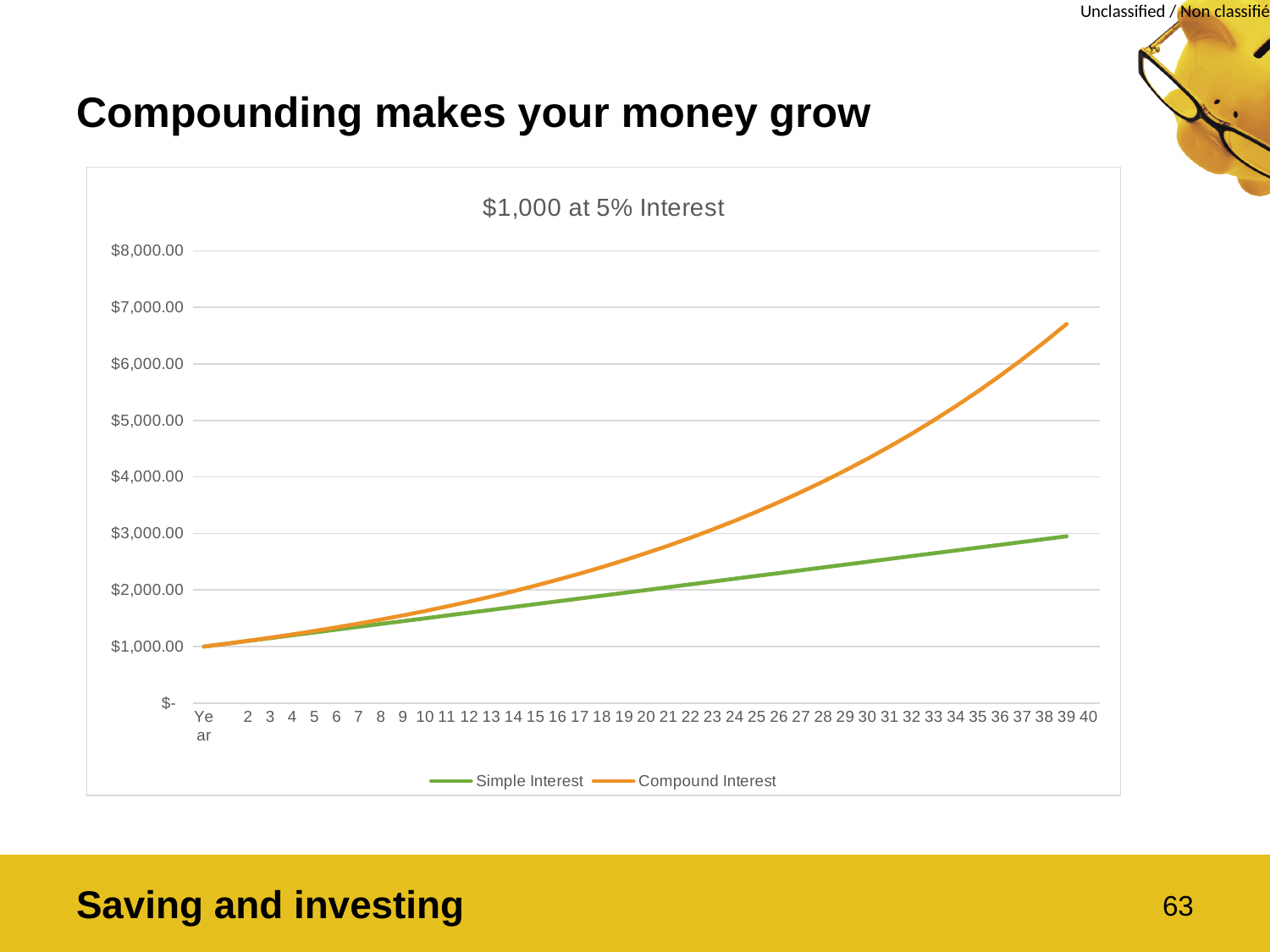
What is the starting value of both series at Year 1? $1,000.00 Is the Compound Interest value at year 20 greater or less than $3,000.00? less Does the Compound Interest line rise or fall as the years increase? rise Which series is drawn in orange? Compound Interest How many series does the chart's legend list? 2 What is the title of the chart? $1,000 at 5% Interest What kind of chart is shown on the slide? line chart